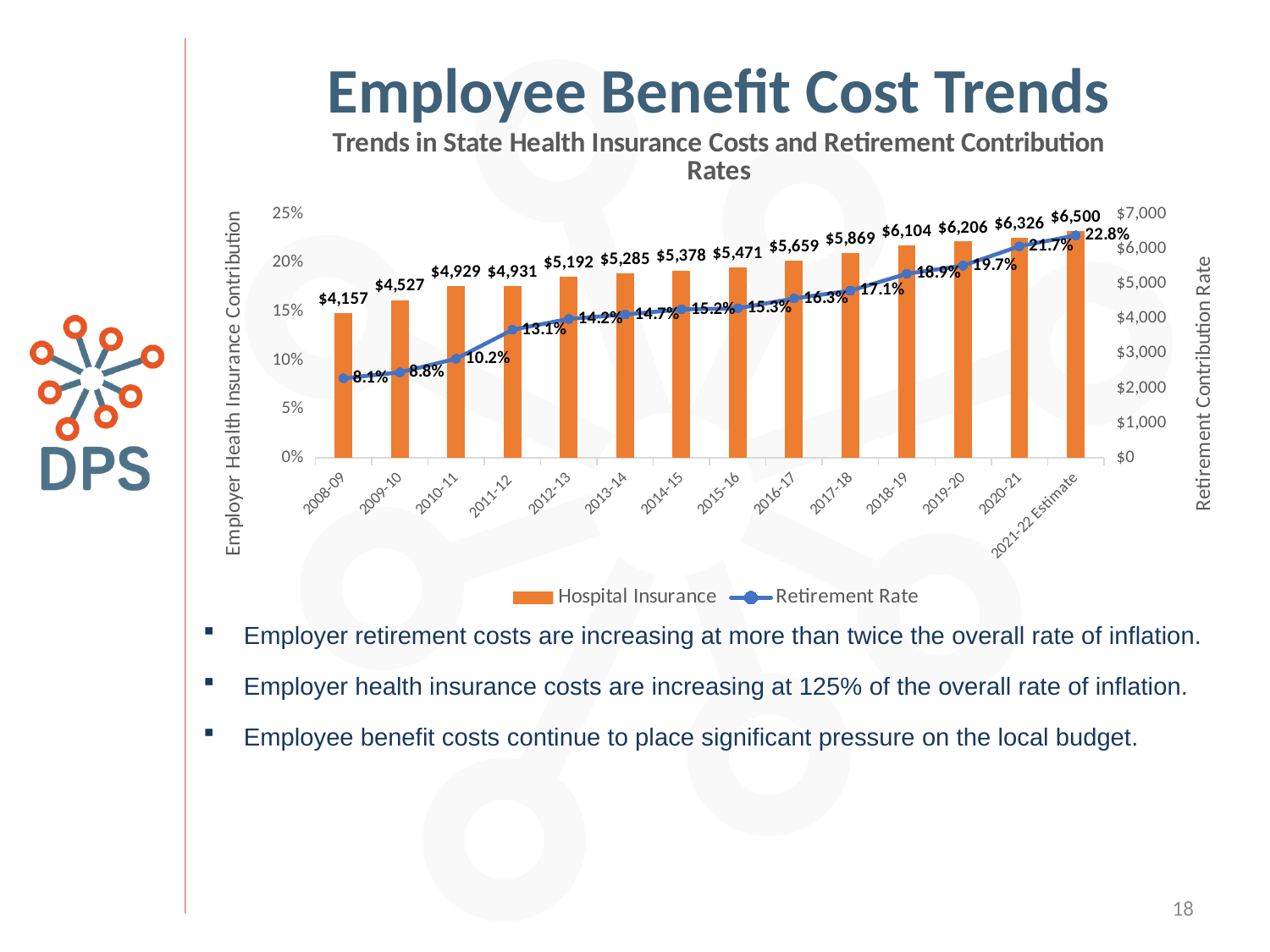
Which year has the lowest Hospital Insurance value? 2008-09 What is the Retirement Rate for 2010-11? 10.2% What is the Retirement Rate for 2015-16? 15.3% What is the Hospital Insurance value for 2021-22 Estimate? $6,500 Which is larger, the Hospital Insurance value for 2012-13 or for 2016-17? 2016-17 Does the Retirement Rate rise or fall from 2008-09 to 2021-22 Estimate? rise What is the difference between the Hospital Insurance values for 2020-21 and 2019-20? $120 What is the difference between the Retirement Rate for 2011-12 and 2010-11? 2.9% Which year has the highest Retirement Rate? 2021-22 Estimate What is the Hospital Insurance value for 2008-09? $4,157 How many series does the legend list? 2 How many years are shown on the x axis? 14